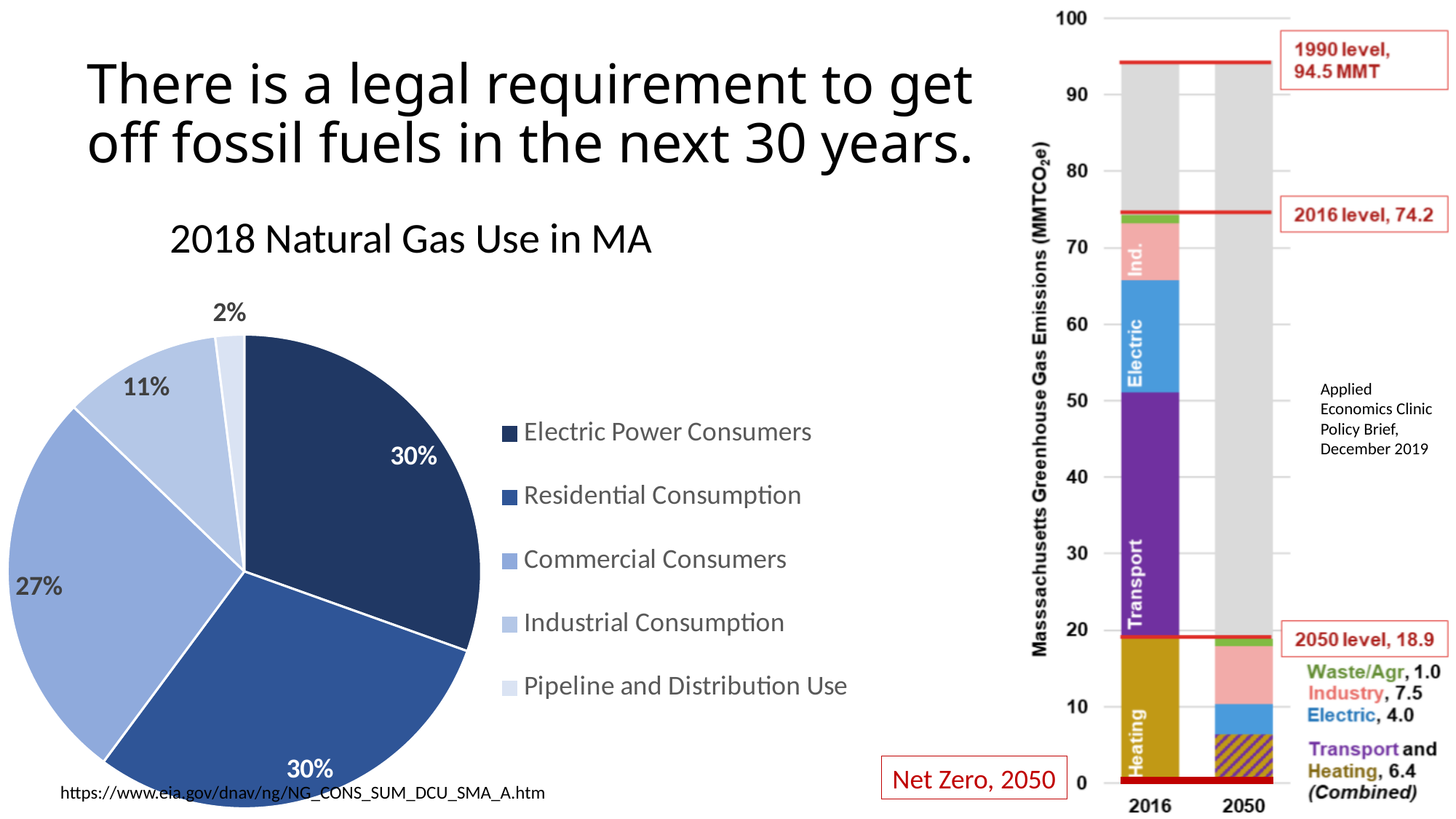
How many categories does the legend of the pie chart '2018 Natural Gas Use in MA' list? 5 In the Massachusetts Greenhouse Gas Emissions chart on the right, do total emissions rise or fall from 2016 to 2050? Fall In the pie chart '2018 Natural Gas Use in MA', how many percentage points larger is Commercial Consumers than Industrial Consumption? 16 percentage points What kind of chart is '2018 Natural Gas Use in MA'? Pie chart In the pie chart '2018 Natural Gas Use in MA', what share is Industrial Consumption? 11% In the pie chart '2018 Natural Gas Use in MA', what share is Commercial Consumers? 27% In the Massachusetts Greenhouse Gas Emissions chart on the right, what is the 2050 level? 18.9 In the Massachusetts Greenhouse Gas Emissions chart on the right, what is the 2016 level? 74.2 In the pie chart '2018 Natural Gas Use in MA', which category has the smallest slice? Pipeline and Distribution Use In the Massachusetts Greenhouse Gas Emissions chart on the right, what is the difference between the 2016 level and the 2050 level? 55.3 In the Massachusetts Greenhouse Gas Emissions chart on the right, what is the 1990 level? 94.5 MMT In the Massachusetts Greenhouse Gas Emissions chart on the right, what is the Industry value for 2050? 7.5